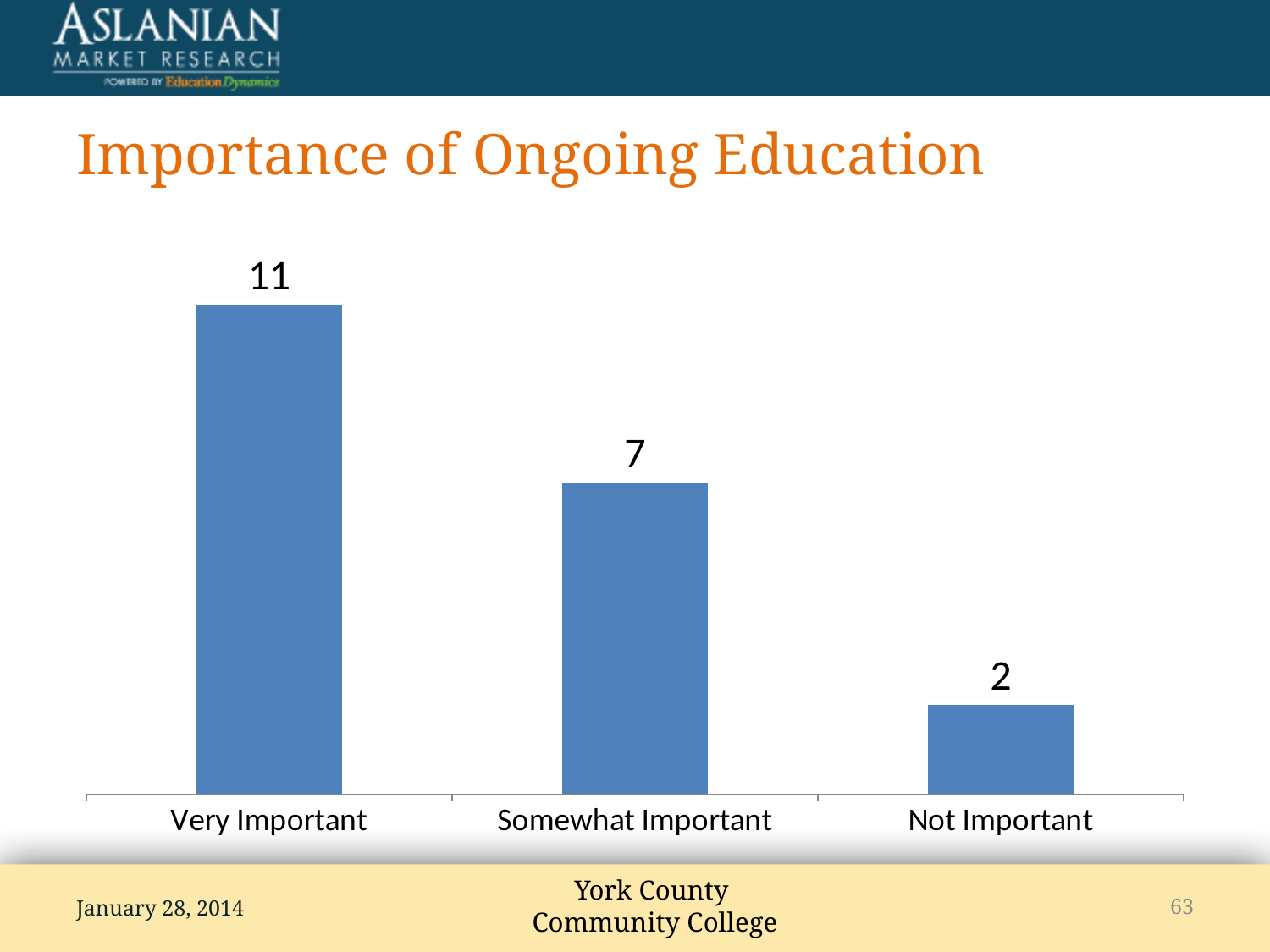
What is the value for Very Important? 11 What is the difference between the values for Somewhat Important and Not Important? 5 What is the value for Somewhat Important? 7 What is the difference between the values for Very Important and Somewhat Important? 4 What is the value for Not Important? 2 Which category has the lowest value? Not Important Which is larger, the value for Somewhat Important or the value for Not Important? Somewhat Important What is the title of the slide containing the chart? Importance of Ongoing Education What kind of chart is shown on the slide? bar chart Do the values rise or fall from left to right across the categories? fall How many categories are shown on the chart? 3 Which category has the highest value? Very Important